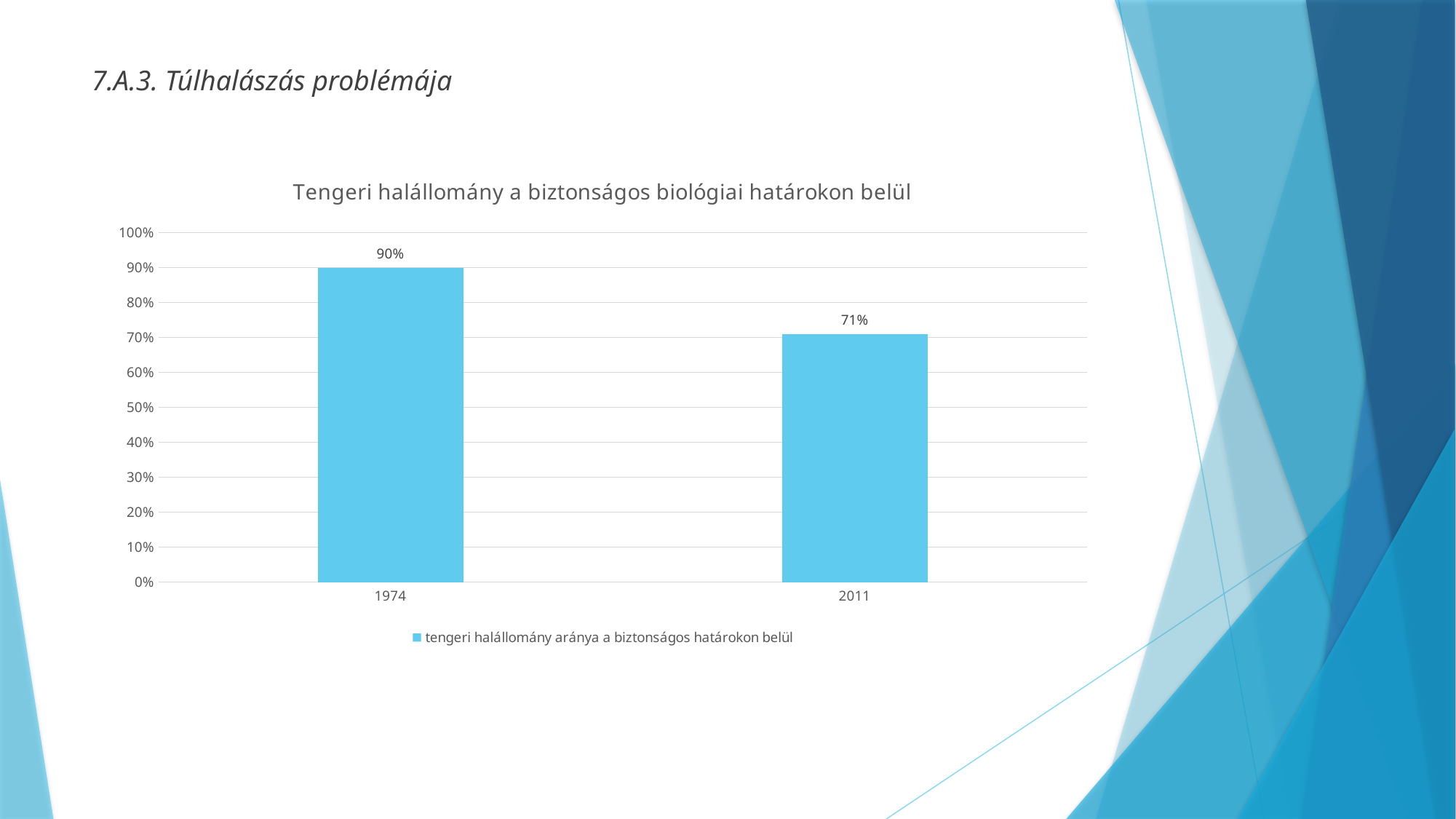
Which year has the lowest value? 2011 Which year has the highest value? 1974 What kind of chart is shown? bar chart Is the value for 2011 greater or less than 80%? less Which is larger, the value for 1974 or the value for 2011? 1974 What is the value for 2011? 71% Do the values rise or fall from 1974 to 2011? fall What is the value for 1974? 90% What is the title of the chart? Tengeri halállomány a biztonságos biológiai határokon belül How many categories are shown on the x axis? 2 How many series does the legend list? 1 What is the difference between the values for 1974 and 2011? 19%